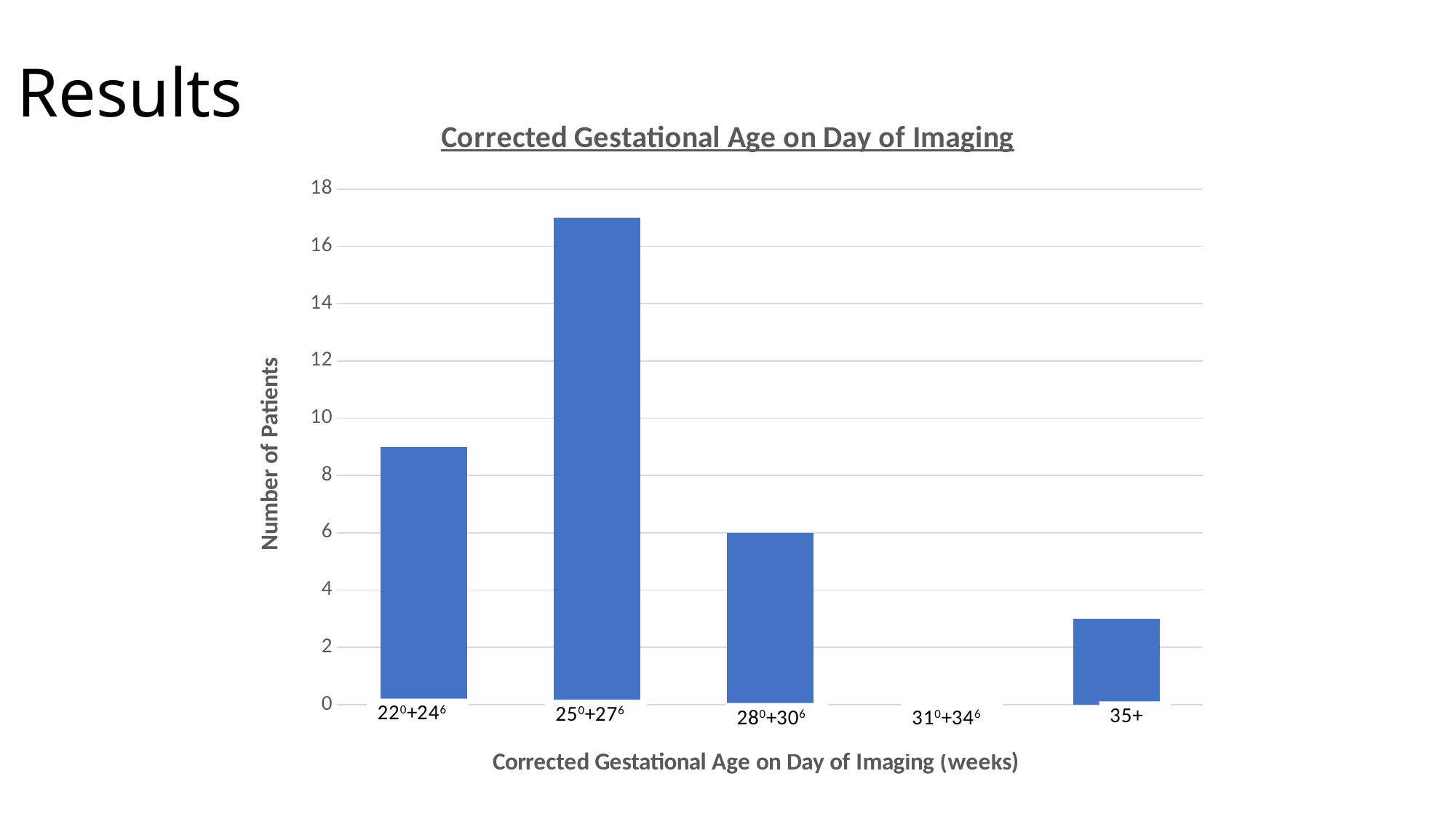
Which category has more patients, 22⁰+24⁶ or 28⁰+30⁶? 22⁰+24⁶ How many patients are in the 31⁰+34⁶ category? 0 Is the number of patients for 35+ greater or less than 4? less How many gestational age categories are shown on the x axis? 5 What is the label on the vertical axis of the chart? Number of Patients Which gestational age category has the highest number of patients? 25⁰+27⁶ What is the title of the chart? Corrected Gestational Age on Day of Imaging How many patients are in the 28⁰+30⁶ category? 6 Is the number of patients for 22⁰+24⁶ greater or less than 8? greater What kind of chart is shown on the slide? bar chart Is the number of patients for 25⁰+27⁶ greater or less than 16? greater Which gestational age category has the lowest number of patients? 31⁰+34⁶